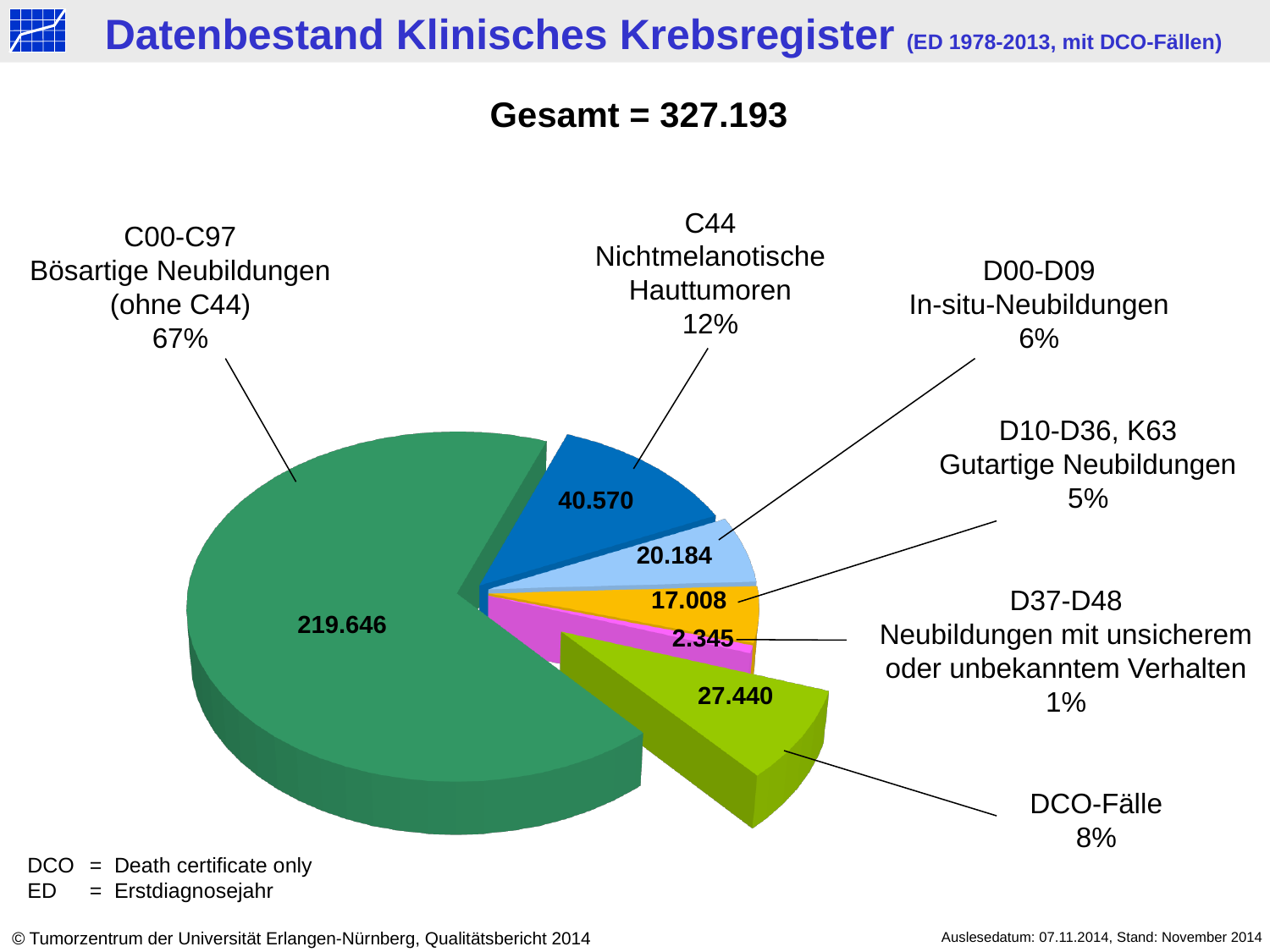
What kind of chart is shown on the slide? pie chart What is the value for D00-D09 In-situ-Neubildungen? 20.184 What is the value for DCO-Fälle? 27.440 What is the value for C00-C97 Bösartige Neubildungen (ohne C44)? 219.646 Which category has the largest slice of the pie? C00-C97 Bösartige Neubildungen (ohne C44) What share of the pie do the DCO-Fälle represent? 8% How many slices does the pie chart have? 6 What is the value for C44 Nichtmelanotische Hauttumoren? 40.570 What is the difference between the value for D00-D09 In-situ-Neubildungen and the value for D10-D36, K63 Gutartige Neubildungen? 3.176 What share of the pie do D10-D36, K63 Gutartige Neubildungen represent? 5% Which is larger, the value for C44 Nichtmelanotische Hauttumoren or the value for DCO-Fälle? C44 Nichtmelanotische Hauttumoren Which category has the smallest slice of the pie? D37-D48 Neubildungen mit unsicherem oder unbekanntem Verhalten